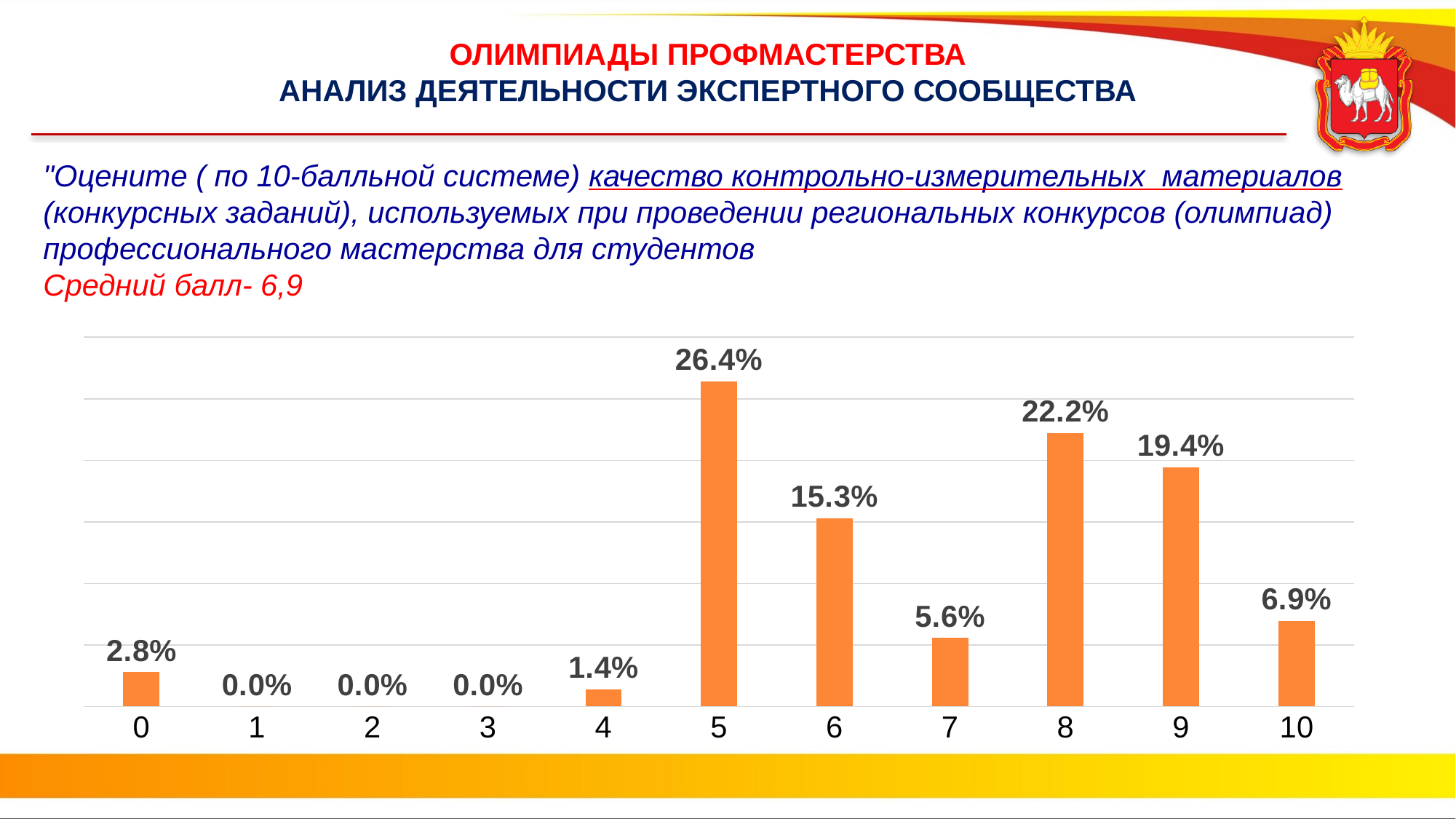
How many scores have a value of 0.0%? 3 What is the value for score 4? 1.4% What is the difference between the values for score 5 and score 8? 4.2% What is the value for score 10? 6.9% What is the difference between the values for score 6 and score 7? 9.7% What is the value for score 8? 22.2% What kind of chart is shown on the slide? bar chart How many score categories are shown on the x axis of the chart? 11 What is the value for score 5? 26.4% Do the values rise or fall from score 5 to score 7? fall Which score has the highest value? 5 Which is larger, the value for score 9 or the value for score 6? score 9